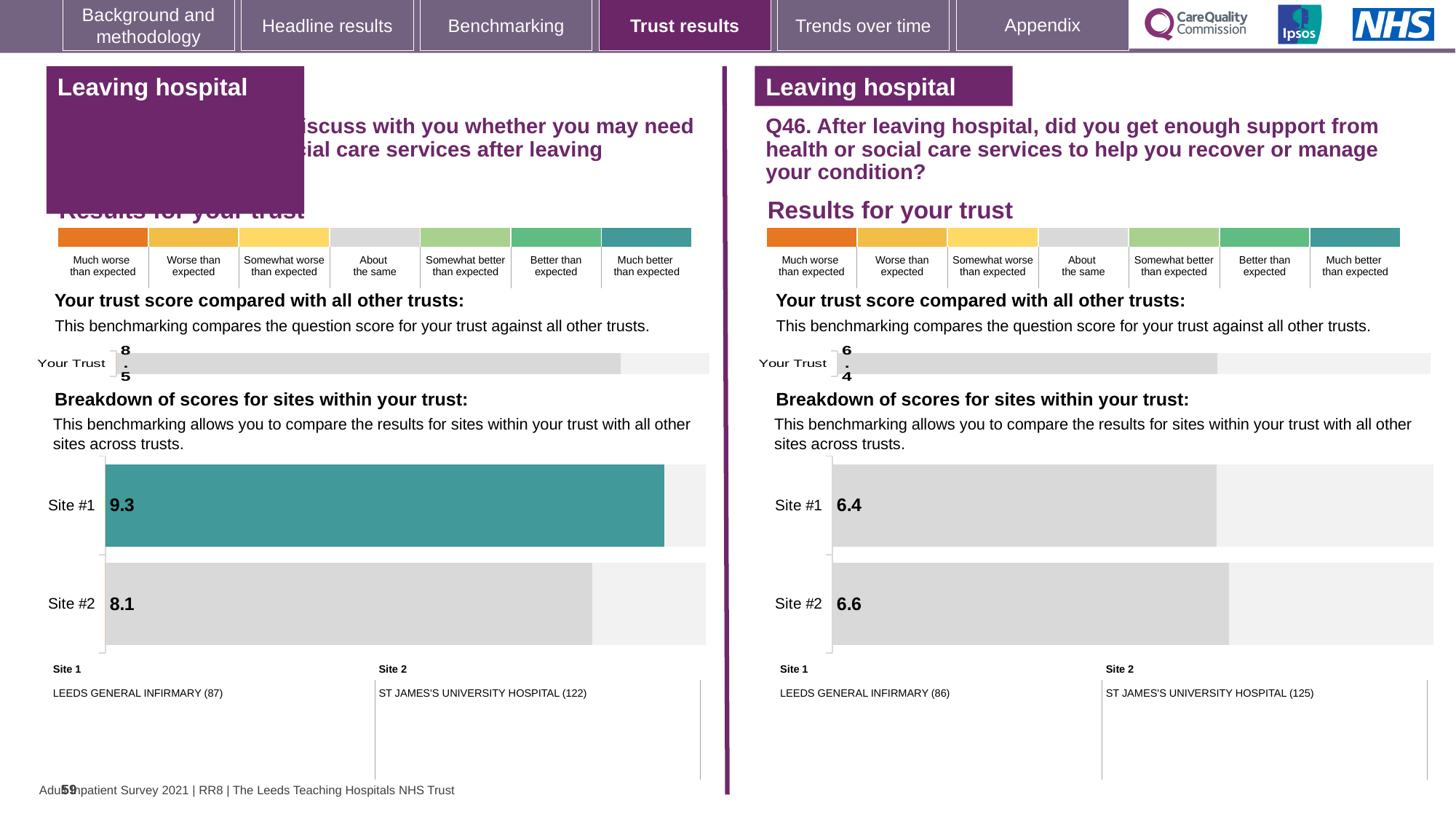
On the right-hand chart (Q46), what is the 'Your Trust' score? 6.4 On the left-hand chart, which site has the higher score? Site #1 On the right-hand chart (Q46), which site has the lower score? Site #1 On the left-hand chart, what is the score for Site #1? 9.3 On the left-hand chart, what is the 'Your Trust' score? 8.5 On the left-hand chart, what is the score for Site #2? 8.1 On the right-hand chart (Q46), what is the difference between the Site #2 and Site #1 scores? 0.2 What type of chart is used for the breakdown of scores for sites on the left-hand side? Bar chart How many sites are shown in the site breakdown chart on the right-hand side (Q46)? 2 On the right-hand chart (Q46), what is the score for Site #1? 6.4 On the right-hand chart (Q46), what is the score for Site #2? 6.6 On the left-hand chart, what is the difference between the Site #1 and Site #2 scores? 1.2